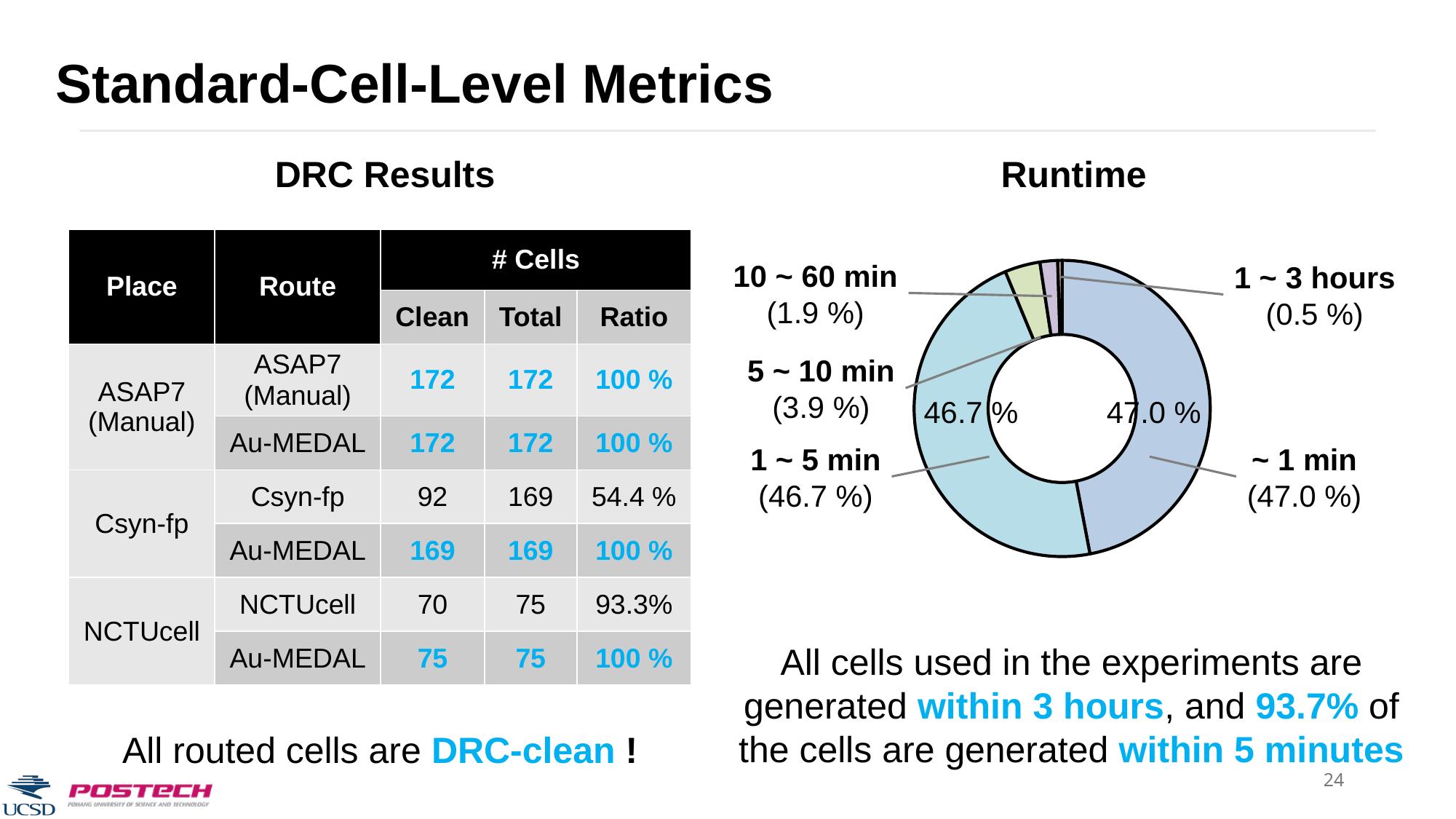
In the Runtime chart, what share of cells are generated in ~ 1 min? 47.0 % In the Runtime chart, what share of cells are generated in 5 ~ 10 min? 3.9 % In the Runtime chart, what is the combined share of ~ 1 min and 1 ~ 5 min? 93.7 % In the Runtime chart, what share of cells are generated in 1 ~ 5 min? 46.7 % In the Runtime chart, which runtime category has the smallest share? 1 ~ 3 hours In the Runtime chart, which runtime category has the largest share? ~ 1 min What kind of chart is the Runtime chart? pie chart (donut) How many runtime categories are shown in the Runtime chart? 5 In the Runtime chart, which has a larger share: 5 ~ 10 min or 10 ~ 60 min? 5 ~ 10 min In the Runtime chart, what share of cells are generated in 10 ~ 60 min? 1.9 % In the Runtime chart, what share of cells are generated in 1 ~ 3 hours? 0.5 % In the Runtime chart, what is the difference in share between ~ 1 min and 1 ~ 5 min? 0.3 %